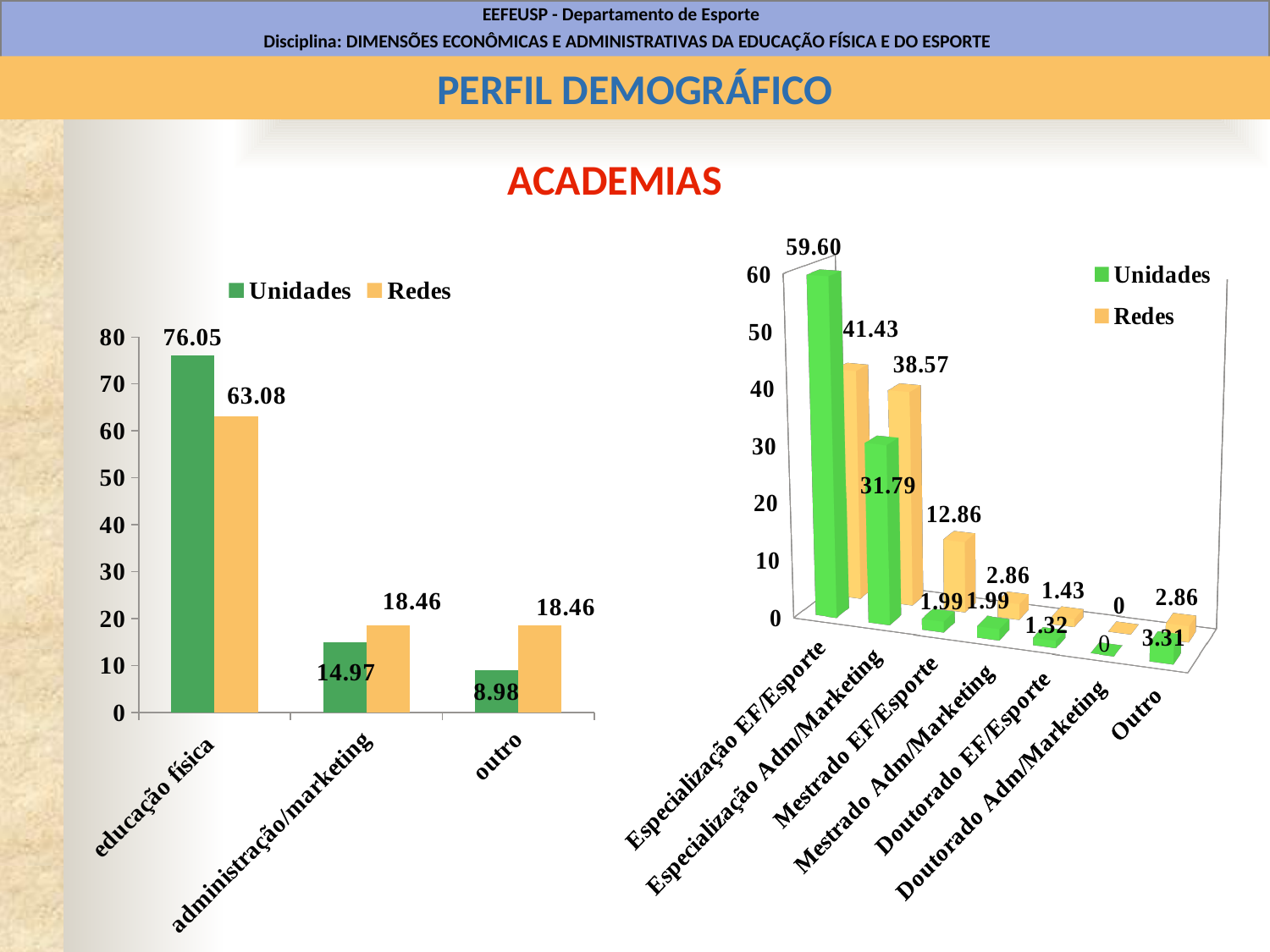
In the left chart, how many categories are shown on the x axis? 3 In the right chart, which category has the lowest Unidades value? Doutorado Adm/Marketing What type of chart is the right chart? bar chart In the right chart, what is the Unidades value for Especialização EF/Esporte? 59.60 In the left chart, which category has the highest Unidades value? educação física In the right chart, which is larger for Especialização Adm/Marketing: Unidades or Redes? Redes In the right chart, what is the Redes value for Mestrado EF/Esporte? 12.86 In the left chart, what is the Redes value for administração/marketing? 18.46 In the left chart, what is the Unidades value for educação física? 76.05 In the left chart, what is the difference between the Unidades and Redes values for educação física? 12.97 In the left chart, what is the Unidades value for outro? 8.98 In the left chart, how many series does the legend list? 2